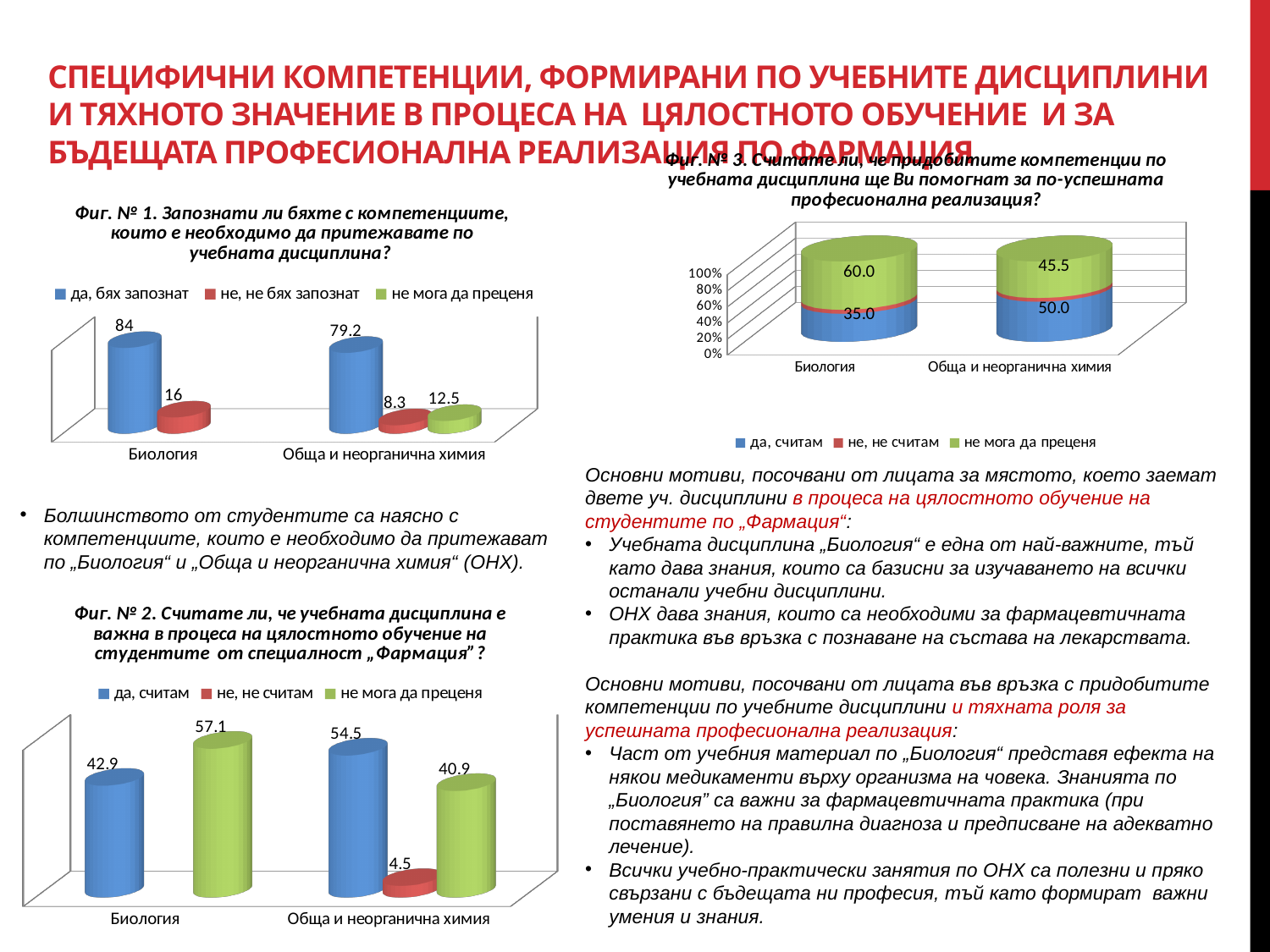
In Фиг. № 2, what is the value for "не мога да преценя" for Биология? 57.1 In Фиг. № 2, what is the value for "не, не считам" for Обща и неорганична химия? 4.5 In Фиг. № 3, what is the value for "да, считам" for Обща и неорганична химия? 50.0 In Фиг. № 1, what is the value for "не мога да преценя" for Обща и неорганична химия? 12.5 In Фиг. № 1, how many series does the legend list? 3 In Фиг. № 1, what is the value for "да, бях запознат" for Биология? 84 In Фиг. № 2, what is the difference between "да, считам" and "не мога да преценя" for Обща и неорганична химия? 13.6 What kind of chart is Фиг. № 2? bar chart In Фиг. № 1, what is the value for "не, не бях запознат" for Обща и неорганична химия? 8.3 In Фиг. № 1, what is the difference between the "да, бях запознат" values for Биология and Обща и неорганична химия? 4.8 In Фиг. № 3, what is the value for "не мога да преценя" for Биология? 60.0 In Фиг. № 2, which is larger for Биология: "да, считам" or "не мога да преценя"? не мога да преценя